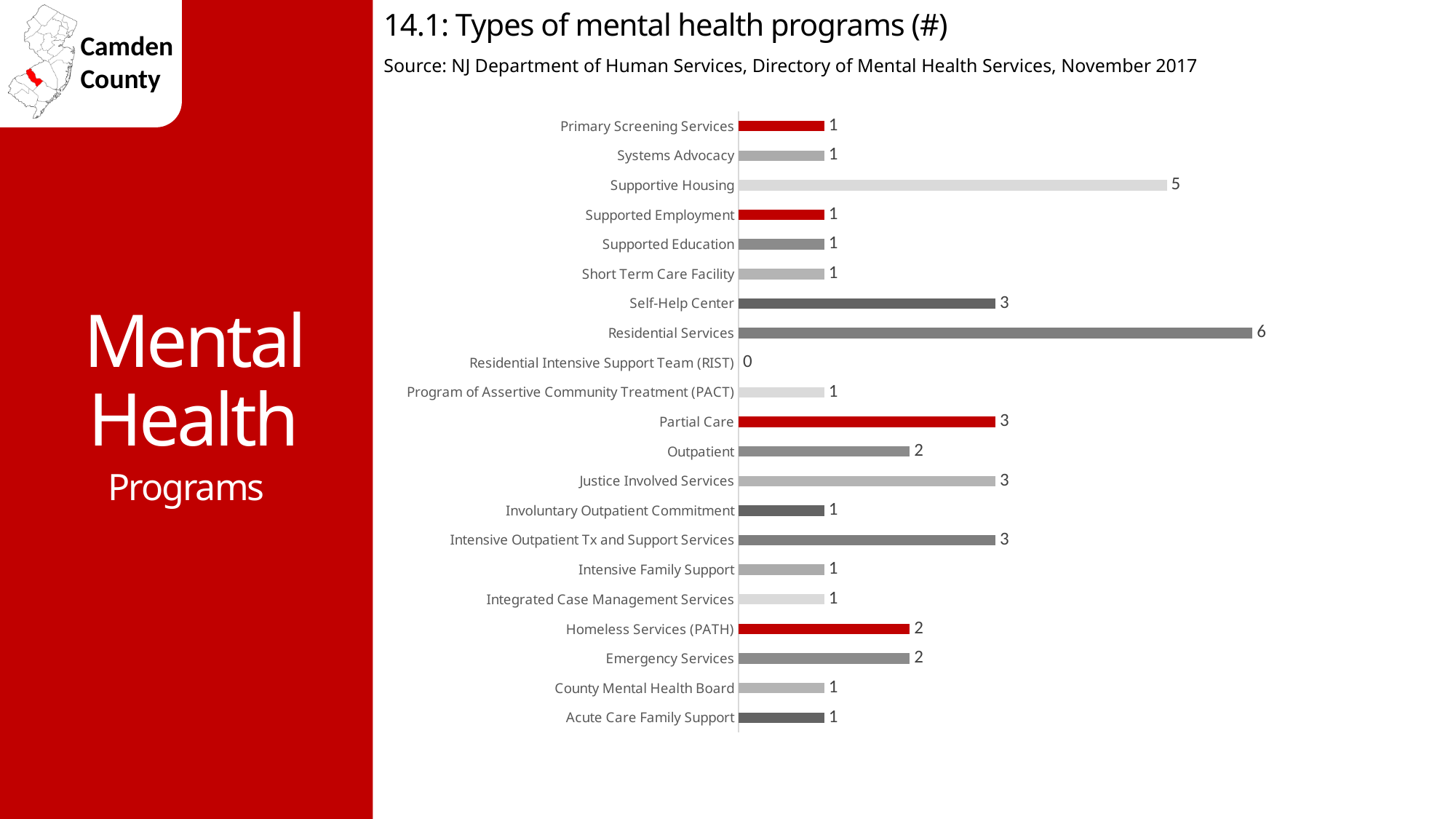
What is the difference between the values for Partial Care and Outpatient? 1 How many program types are listed in the chart? 21 What is the value for Residential Intensive Support Team (RIST)? 0 Which type of mental health program has the lowest number? Residential Intensive Support Team (RIST) What is the value for Supportive Housing? 5 Which type of mental health program has the highest number? Residential Services What kind of chart is shown on the slide? Bar chart What is the title of the chart? 14.1: Types of mental health programs (#) Which has a larger value, Self-Help Center or Emergency Services? Self-Help Center What is the value for Homeless Services (PATH)? 2 What is the difference between the values for Residential Services and Supportive Housing? 1 How many Residential Services programs are shown in the chart? 6